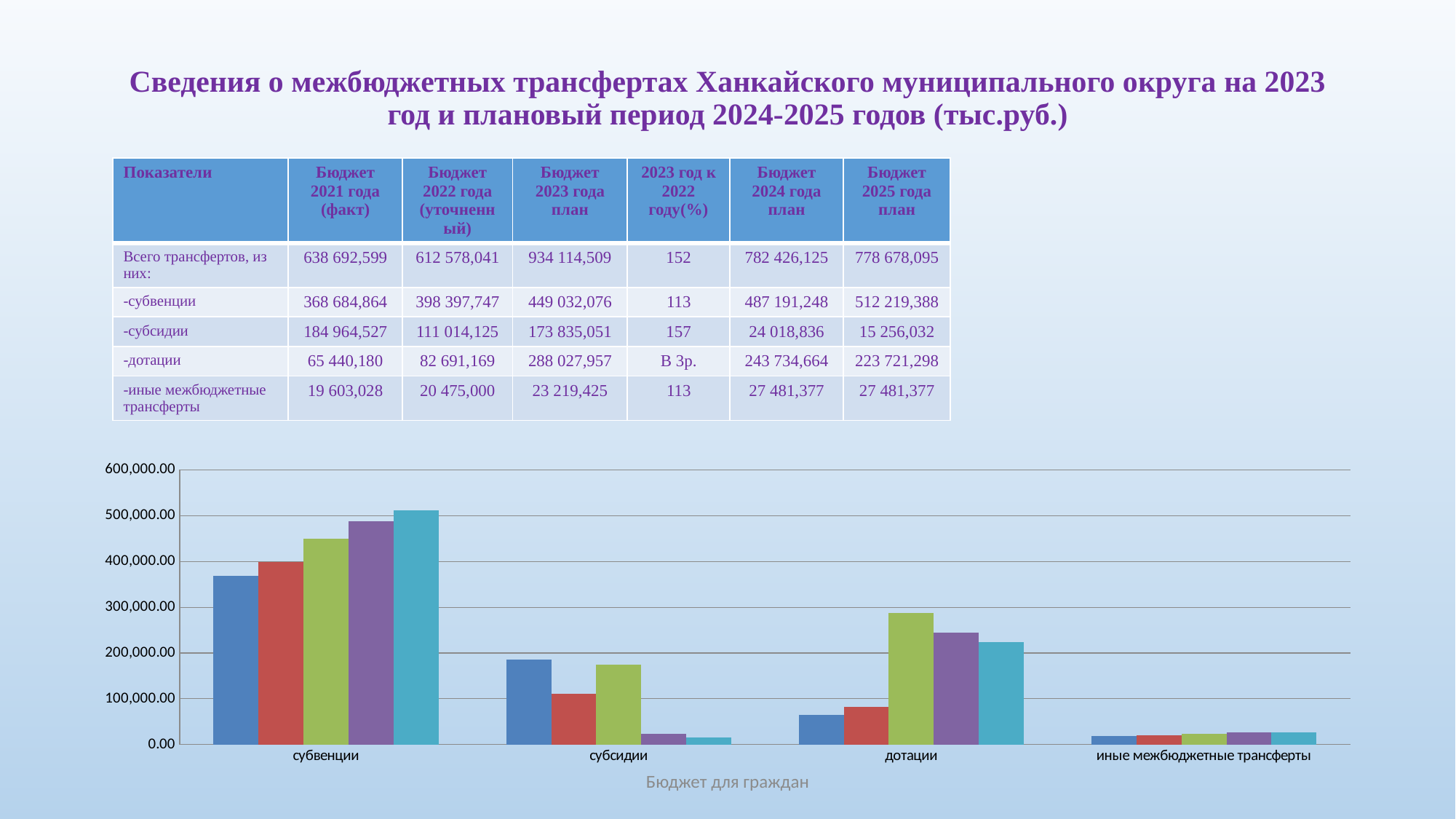
Which category in the bar chart has the tallest bars? субвенции Which category in the bar chart has the shortest bars? иные межбюджетные трансферты In the bar chart, is the teal (last) bar for субвенции greater or less than 500,000.00? greater How many bars are plotted for each category in the bar chart? 5 What kind of chart is shown at the bottom of the slide? bar chart How many categories are shown on the x axis of the bar chart? 4 In the bar chart, is the green (third) bar for дотации greater or less than 200,000.00? greater In the bar chart, do the five bars for субвенции rise or fall from left to right? rise In the bar chart, is the blue (first) bar for субвенции greater or less than 300,000.00? greater What is the axis title shown below the x axis of the bar chart? Бюджет для граждан